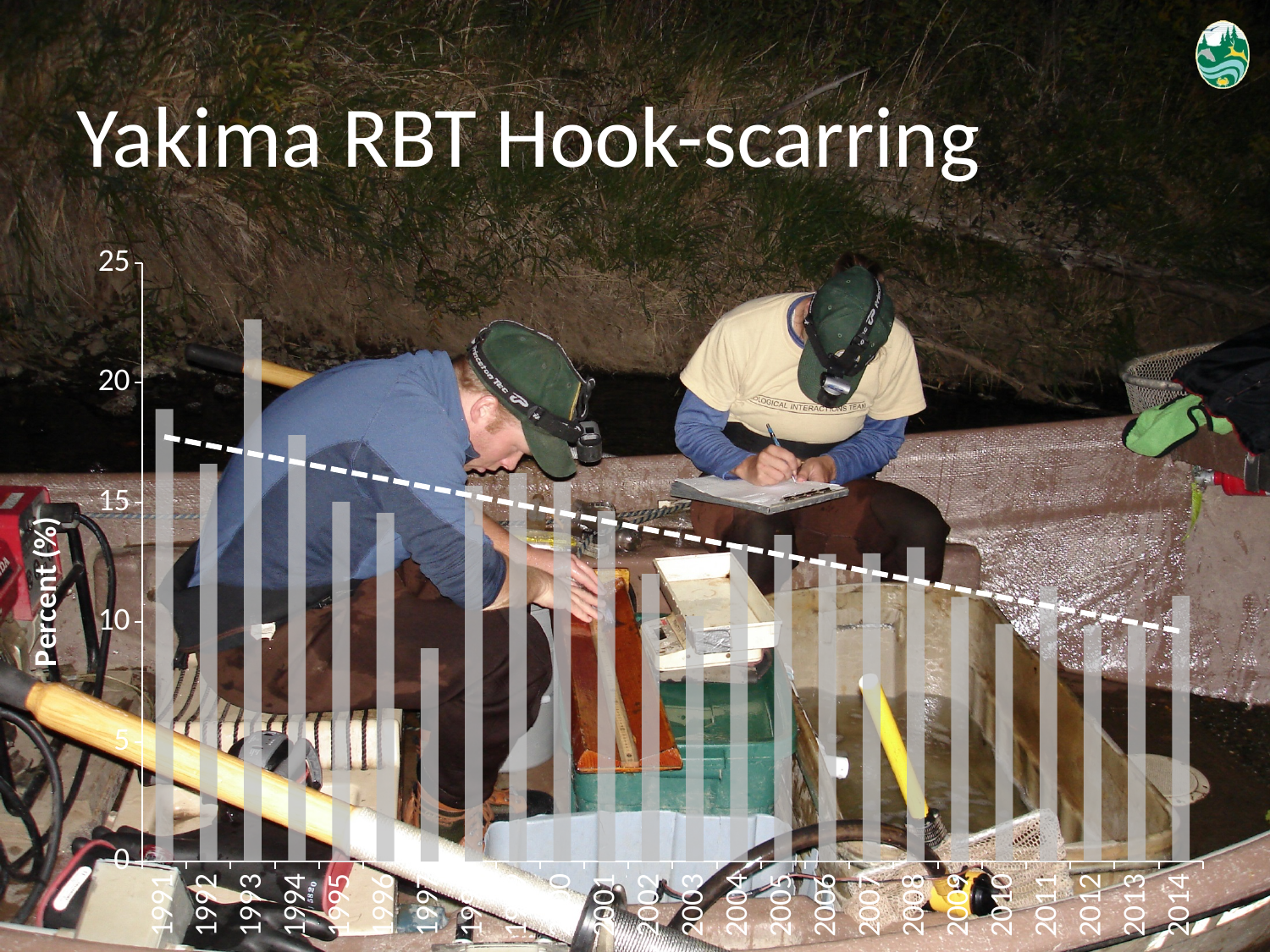
What is the title of the chart on the slide? Yakima RBT Hook-scarring Is the value for 1997 greater or less than 10? less What kind of chart is shown on the slide? bar chart Which year has the highest hook-scarring percentage? 1993 Does the dashed trend line show hook-scarring percentage rising or falling from 1991 to 2014? falling How many years are shown on the x axis of the chart? 24 Is the value for 1991 greater or less than 20? less What is the label on the vertical axis of the chart? Percent (%) Is the value for 2007 greater or less than 10? greater Which is larger, the value for 1993 or the value for 2007? 1993